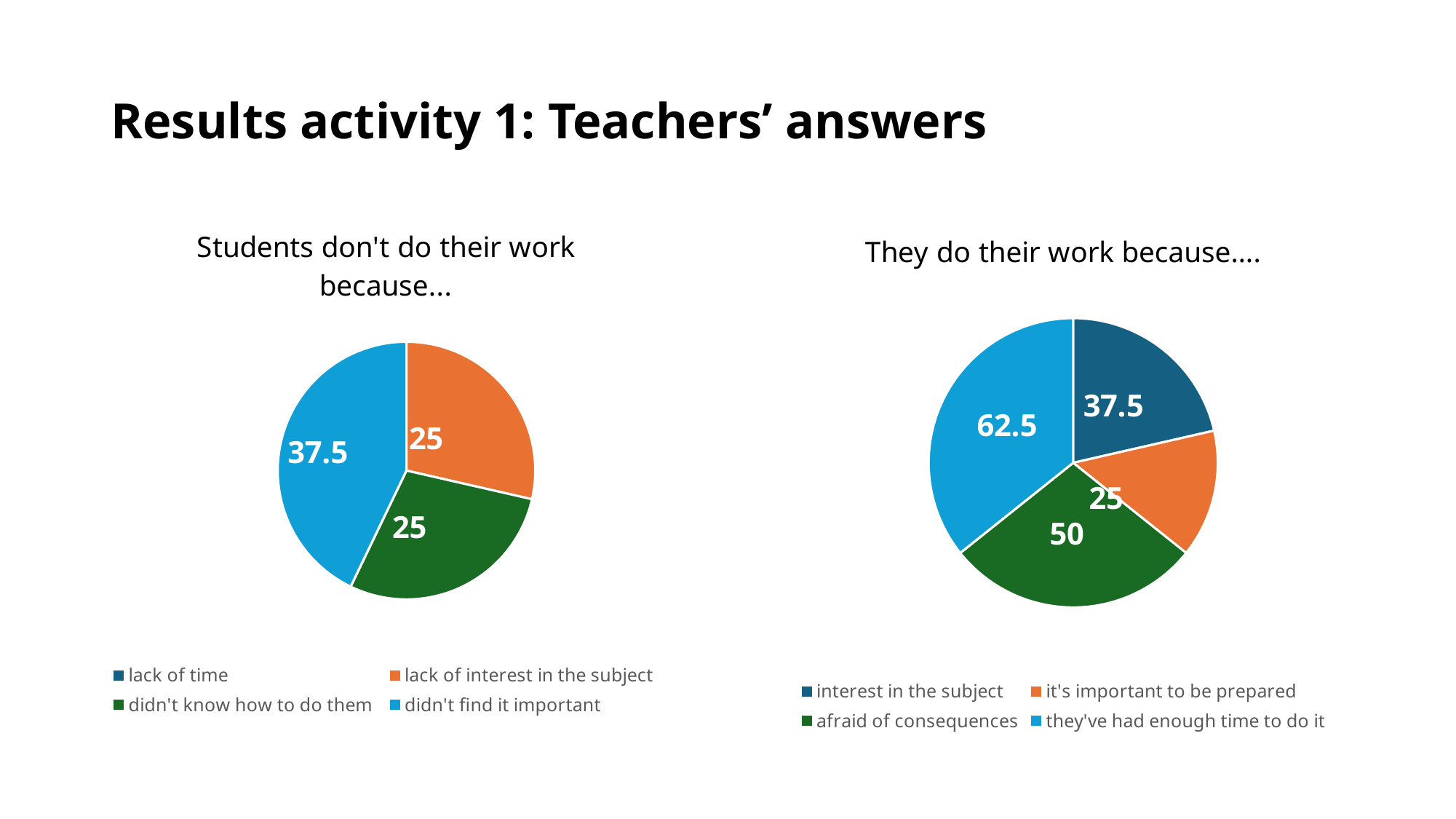
In the chart titled "They do their work because....", what is the difference between the values for "they've had enough time to do it" and "interest in the subject"? 25 In the chart titled "Students don't do their work because...", what is the value for "didn't find it important"? 37.5 In the chart titled "They do their work because....", what is the value for "afraid of consequences"? 50 In the chart titled "They do their work because....", which category has the smallest slice? it's important to be prepared In the chart titled "They do their work because....", which is larger: "afraid of consequences" or "interest in the subject"? afraid of consequences In the chart titled "Students don't do their work because...", what is the value for "lack of interest in the subject"? 25 In the chart titled "They do their work because....", what is the value for "they've had enough time to do it"? 62.5 In the chart titled "They do their work because....", which category has the largest slice? they've had enough time to do it How many entries does the legend of the chart titled "Students don't do their work because..." list? 4 In the chart titled "Students don't do their work because...", which category has the largest slice? didn't find it important What kind of chart is the chart titled "They do their work because...."? pie chart In the chart titled "They do their work because....", what colour is the slice for "afraid of consequences"? green